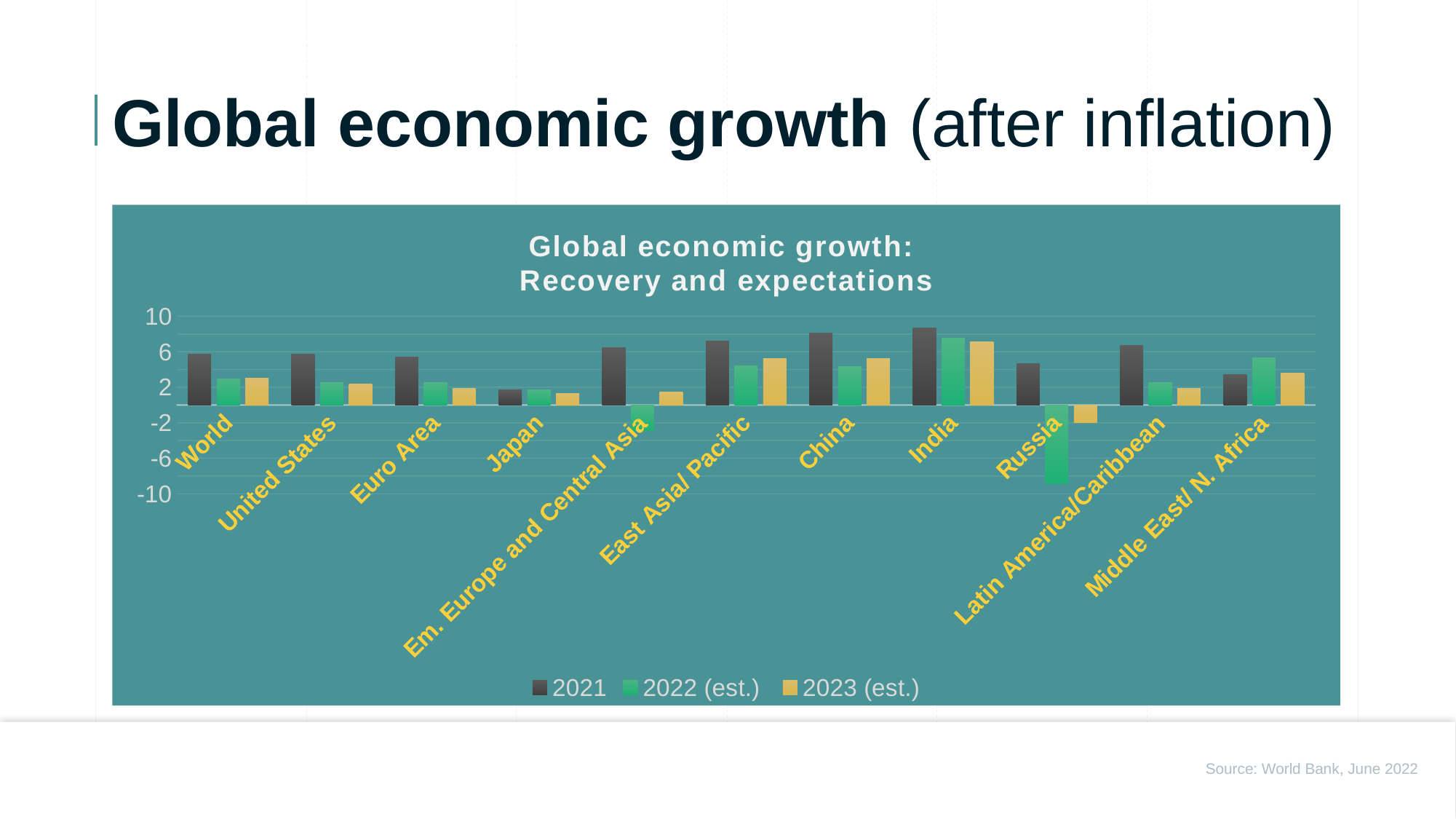
Is the 2023 (est.) value for Japan greater or less than 2? less What is the title of the chart? Global economic growth: Recovery and expectations Is the 2022 (est.) value for Russia greater or less than -6? less Is the 2021 value for India greater or less than 6? greater How many regions/countries are shown on the x axis? 11 Which is larger for Middle East/N. Africa: the 2021 value or the 2022 (est.) value? 2022 (est.) What kind of chart is shown on the slide? bar chart Which region has the lowest 2022 (est.) value? Russia How many series does the legend list? 3 Which is larger for China: the 2021 value or the 2022 (est.) value? 2021 Which region has the highest 2021 value? India